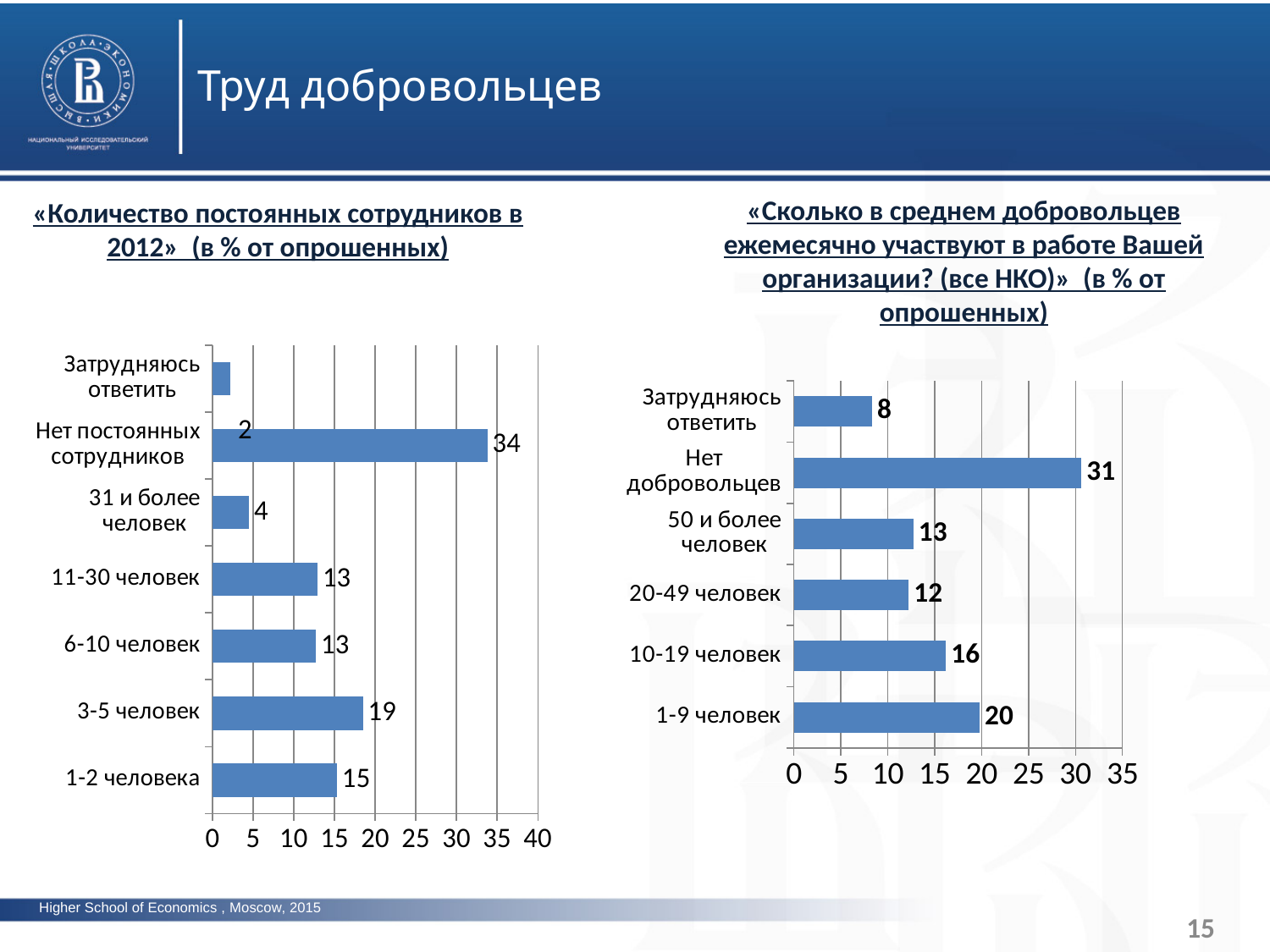
In the left chart «Количество постоянных сотрудников в 2012», what is the value for «Нет постоянных сотрудников»? 34 In the right chart «Сколько в среднем добровольцев ежемесячно участвуют в работе Вашей организации?», how many categories are shown? 6 What type of chart is the right chart «Сколько в среднем добровольцев ежемесячно участвуют в работе Вашей организации?»? bar chart In the left chart «Количество постоянных сотрудников в 2012», is the value for «Затрудняюсь ответить» greater or less than 5? less In the right chart «Сколько в среднем добровольцев ежемесячно участвуют в работе Вашей организации?», what is the value for «10-19 человек»? 16 In the right chart «Сколько в среднем добровольцев ежемесячно участвуют в работе Вашей организации?», what is the difference between «Нет добровольцев» and «1-9 человек»? 11 In the left chart «Количество постоянных сотрудников в 2012», what is the difference between «3-5 человек» and «1-2 человека»? 4 In the left chart «Количество постоянных сотрудников в 2012», how many categories are shown? 7 In the right chart «Сколько в среднем добровольцев ежемесячно участвуют в работе Вашей организации?», which category has the lowest value? Затрудняюсь ответить In the left chart «Количество постоянных сотрудников в 2012», what is the value for «3-5 человек»? 19 In the left chart «Количество постоянных сотрудников в 2012», which category has the highest value? Нет постоянных сотрудников In the right chart «Сколько в среднем добровольцев ежемесячно участвуют в работе Вашей организации?», which is larger: «1-9 человек» or «20-49 человек»? 1-9 человек